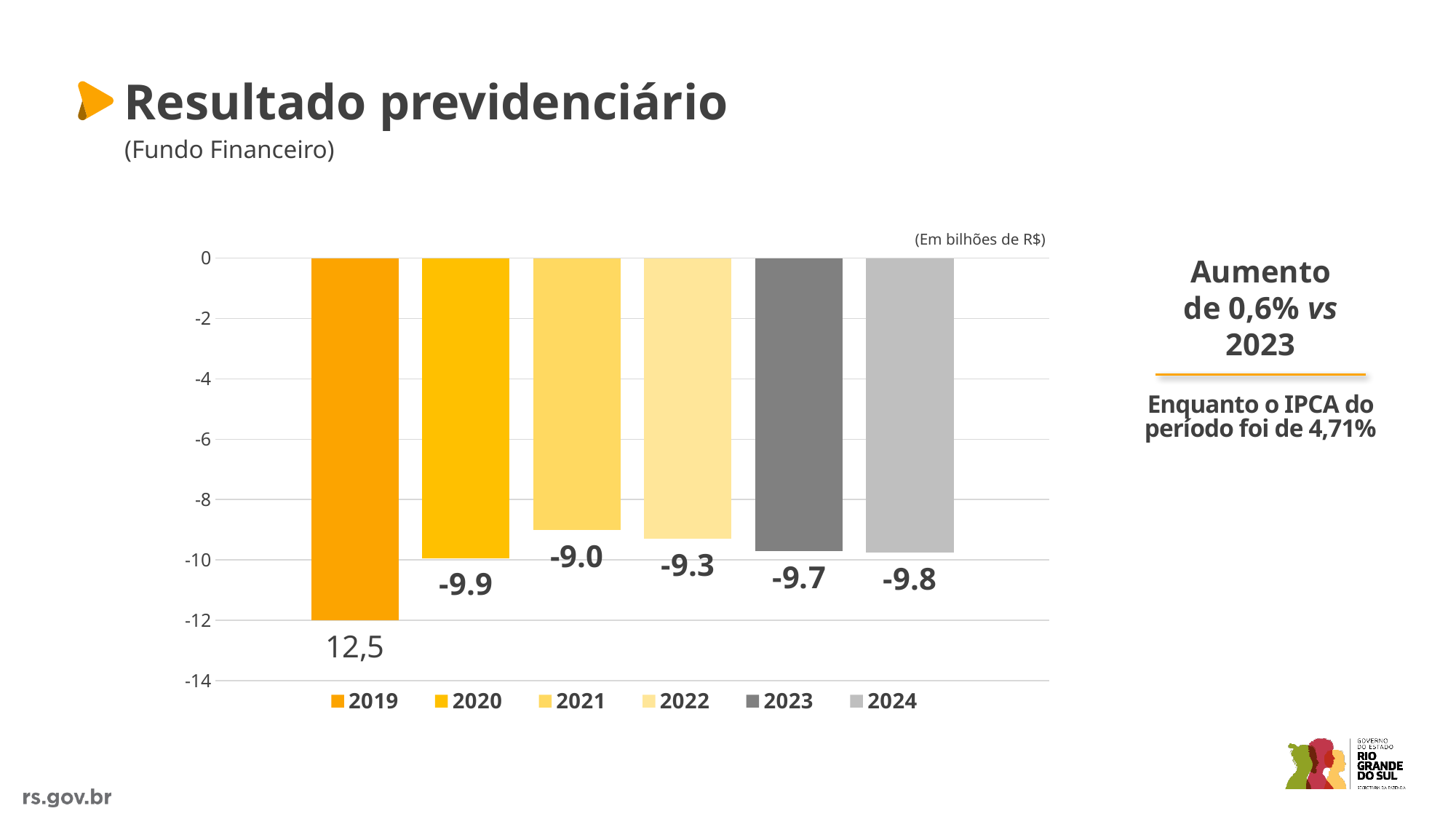
What is the value shown for 2021? -9.0 How many entries does the legend list? 6 What is the value shown for 2020? -9.9 What data label is printed under the 2019 bar? 12,5 What is the difference between the values for 2021 and 2020? 0.9 Which year has the highest (least negative) value? 2021 Which year has the bar extending furthest below zero? 2019 What unit is indicated above the chart? Em bilhões de R$ What kind of chart is shown on the slide? bar chart How many bars are plotted in the chart? 6 What is the value shown for 2024? -9.8 Which is larger, the value for 2023 or the value for 2024? 2023